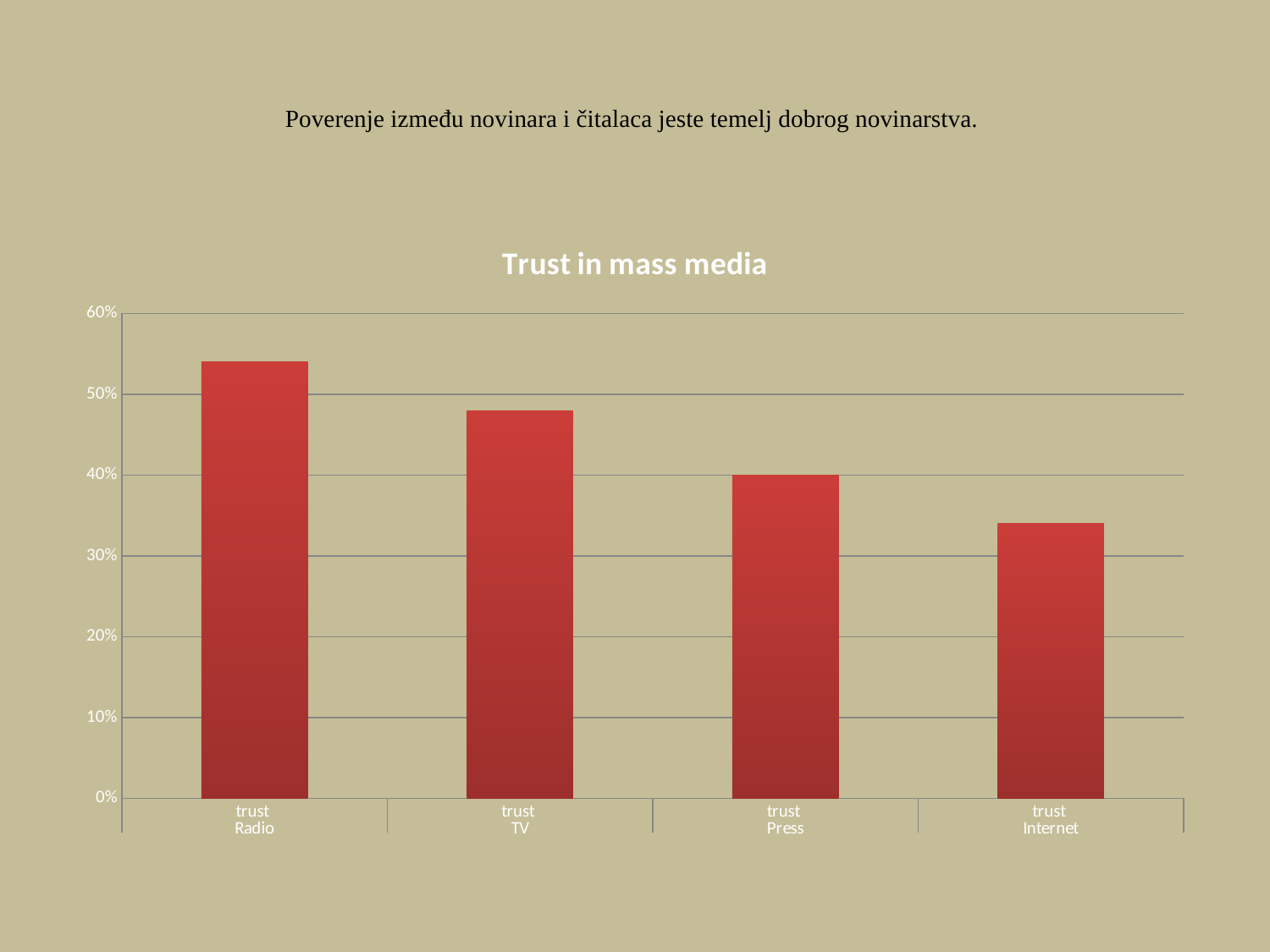
Which category has the lowest value? trust Internet What kind of chart is shown on the slide? bar chart What is the value for trust Press? 40% What is the highest value shown on the vertical axis? 60% How many categories are plotted in the chart? 4 What is the title of the chart? Trust in mass media Is the value for trust Internet greater or less than 30%? greater Do the values rise or fall from left to right across the categories? fall Is the value for trust TV greater or less than 50%? less Which is larger, the value for trust TV or the value for trust Press? trust TV Which category has the highest value? trust Radio Is the value for trust Radio greater or less than 50%? greater